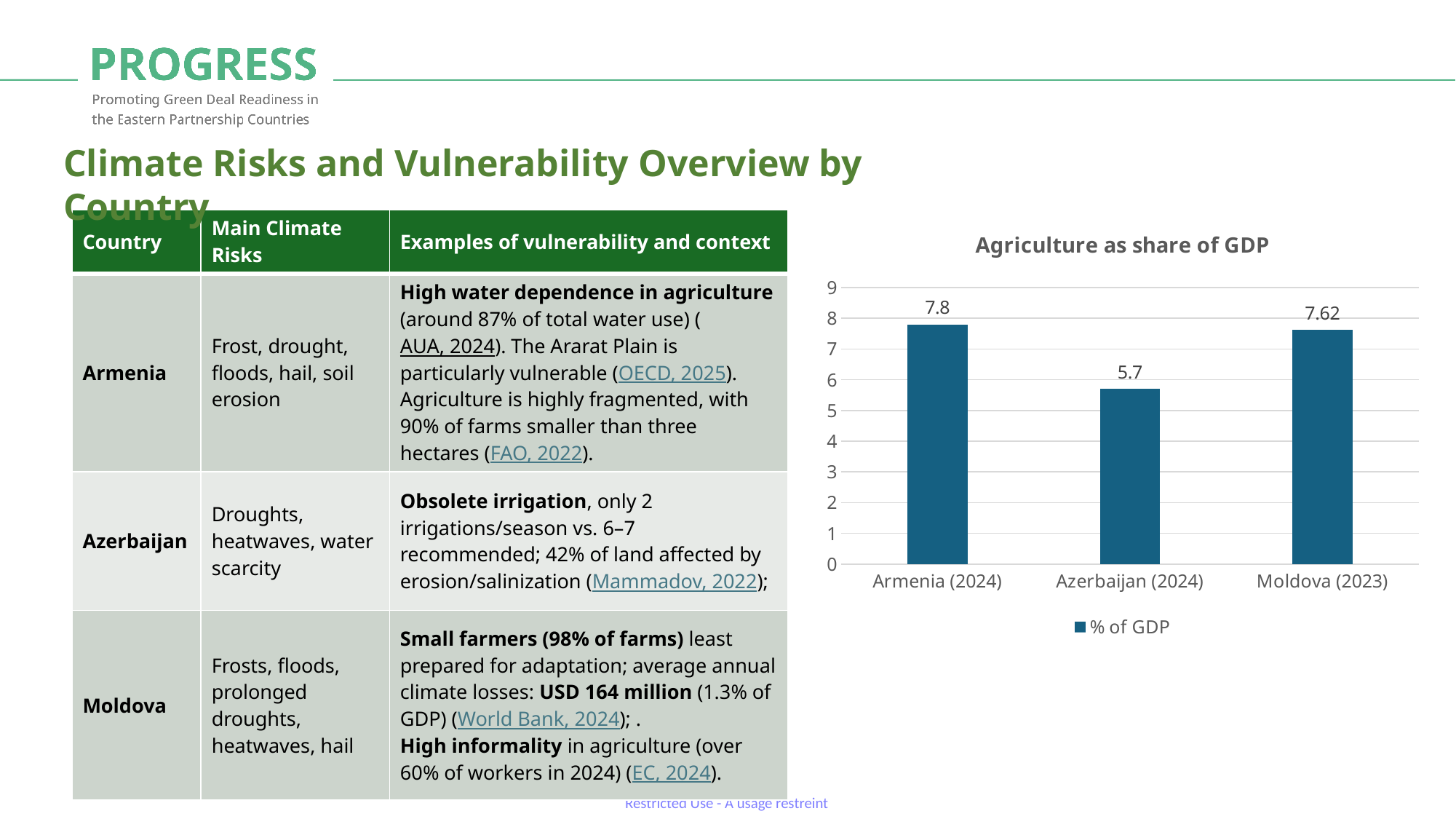
Which category has the highest value in the Agriculture as share of GDP chart? Armenia (2024) What kind of chart is the Agriculture as share of GDP chart? bar chart How many categories are shown in the Agriculture as share of GDP chart? 3 What is the value for Armenia (2024) in the Agriculture as share of GDP chart? 7.8 What is the value for Azerbaijan (2024) in the Agriculture as share of GDP chart? 5.7 What series does the legend of the Agriculture as share of GDP chart list? % of GDP What is the value for Moldova (2023) in the Agriculture as share of GDP chart? 7.62 What is the difference between the values for Armenia (2024) and Azerbaijan (2024)? 2.1 What is the difference between the values for Moldova (2023) and Azerbaijan (2024)? 1.92 Which category has the lowest value in the Agriculture as share of GDP chart? Azerbaijan (2024) Which is larger, the value for Moldova (2023) or the value for Azerbaijan (2024)? Moldova (2023) Is the value for Azerbaijan (2024) greater or less than 6? less